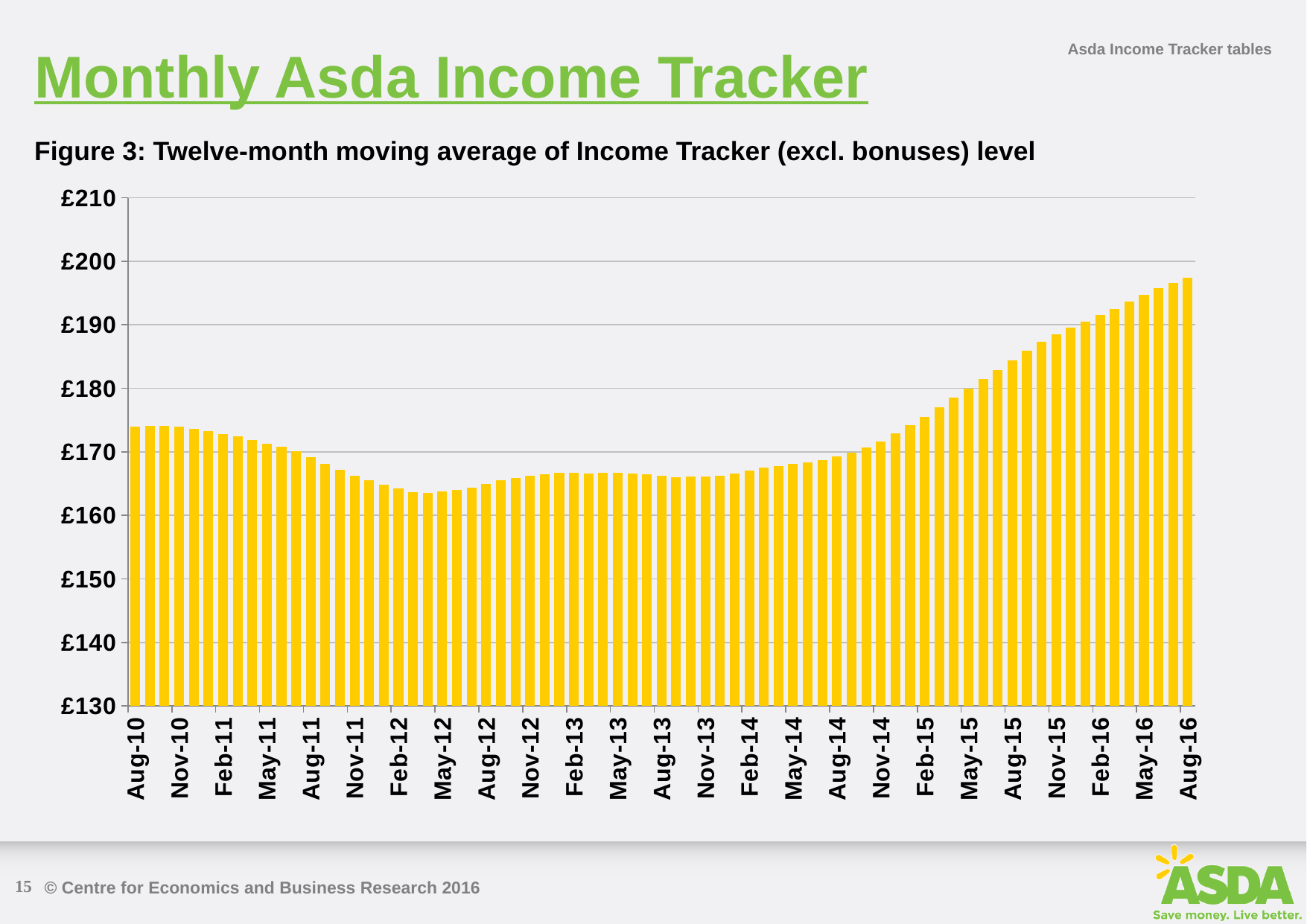
Is the value for Aug-10 greater or less than £170? greater Which is larger, the value for Feb-13 or the value for Feb-15? Feb-15 Is the value for Aug-16 greater or less than £190? greater What colour are the bars in the chart? Yellow Is the value for May-13 greater or less than £170? less Do the values rise or fall from Nov-14 to Aug-16? Rise Which is larger, the value for Aug-10 or the value for Aug-16? Aug-16 What kind of chart is shown on the slide? Bar chart Which month has the highest value in the chart? Aug-16 What is the title of the figure on the slide? Figure 3: Twelve-month moving average of Income Tracker (excl. bonuses) level